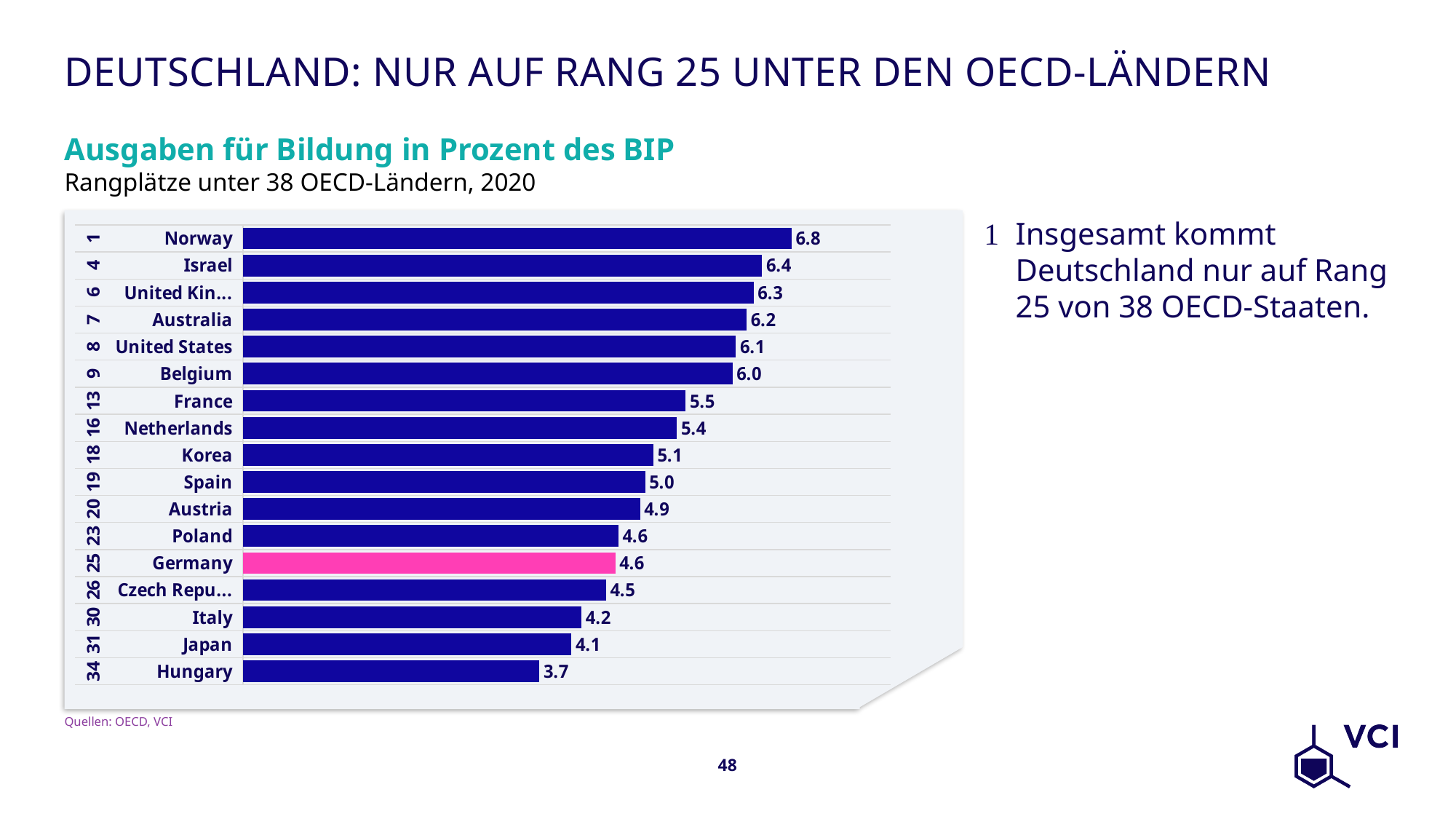
What is the difference between the values for France and Italy? 1.3 Which is larger, the value for Korea or the value for Japan? Korea What is the value for Germany? 4.6 What is the value for Netherlands? 5.4 How many countries are shown in the chart? 17 What is the value for Hungary? 3.7 Which country has the lowest value? Hungary Which country's bar is highlighted in pink? Germany Which country has the highest value? Norway What is the value for Norway? 6.8 What is the difference between the values for Norway and Germany? 2.2 What kind of chart is this? Bar chart